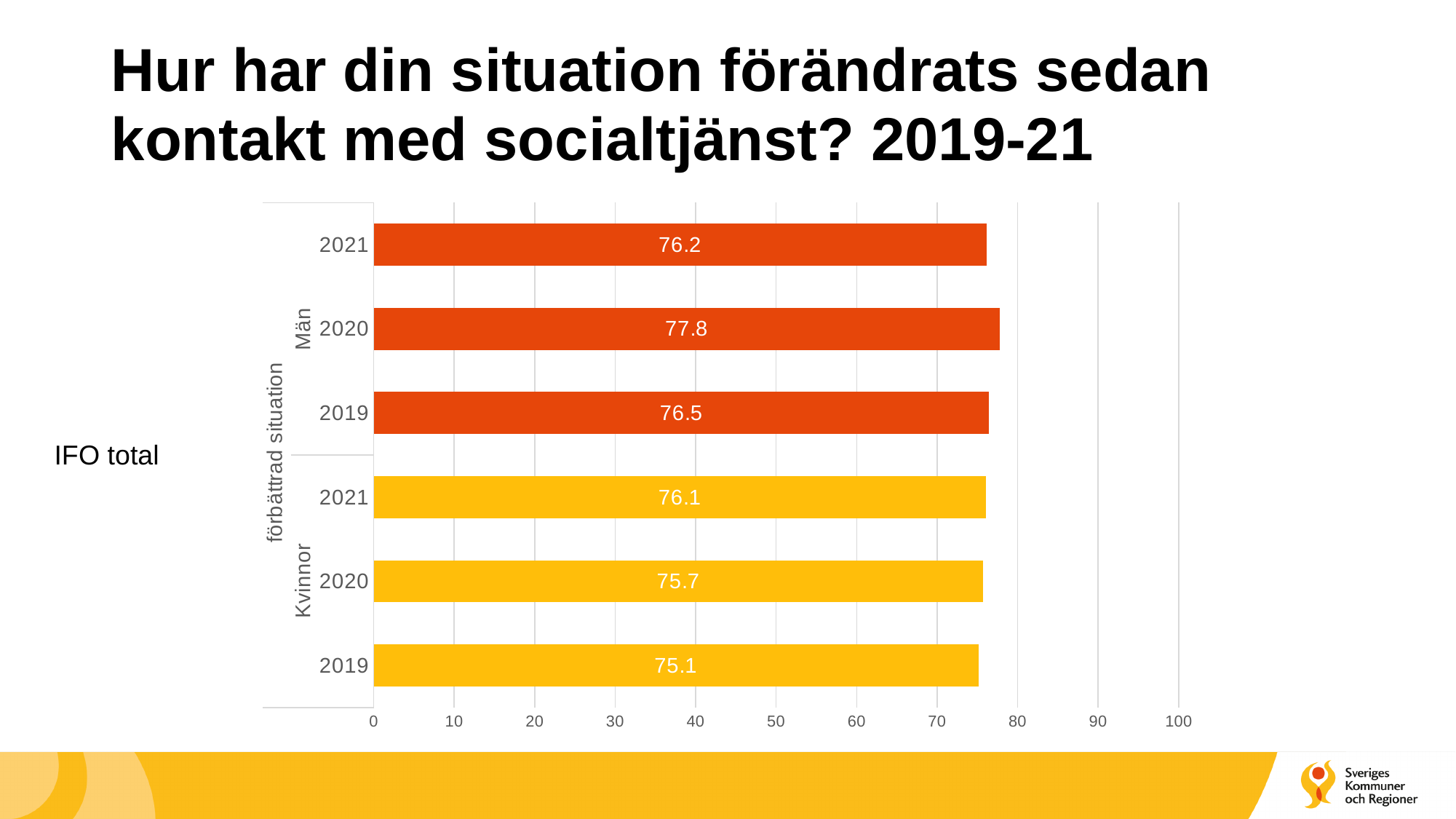
How many bars are shown in the chart? 6 What is the difference between the value for Kvinnor in 2021 and Kvinnor in 2019? 1.0 What is the value for Kvinnor in 2019? 75.1 What is the value for Män in 2020? 77.8 Which bar has the lowest value? Kvinnor 2019 What is the difference between the value for Män in 2020 and Kvinnor in 2020? 2.1 Is the value for Kvinnor in 2020 greater or less than 80? less Which is larger, the value for Män in 2021 or Kvinnor in 2021? Män in 2021 Which bar has the highest value? Män 2020 What is the value for Män in 2019? 76.5 What is the value for Kvinnor in 2021? 76.1 What kind of chart is shown on the slide? bar chart